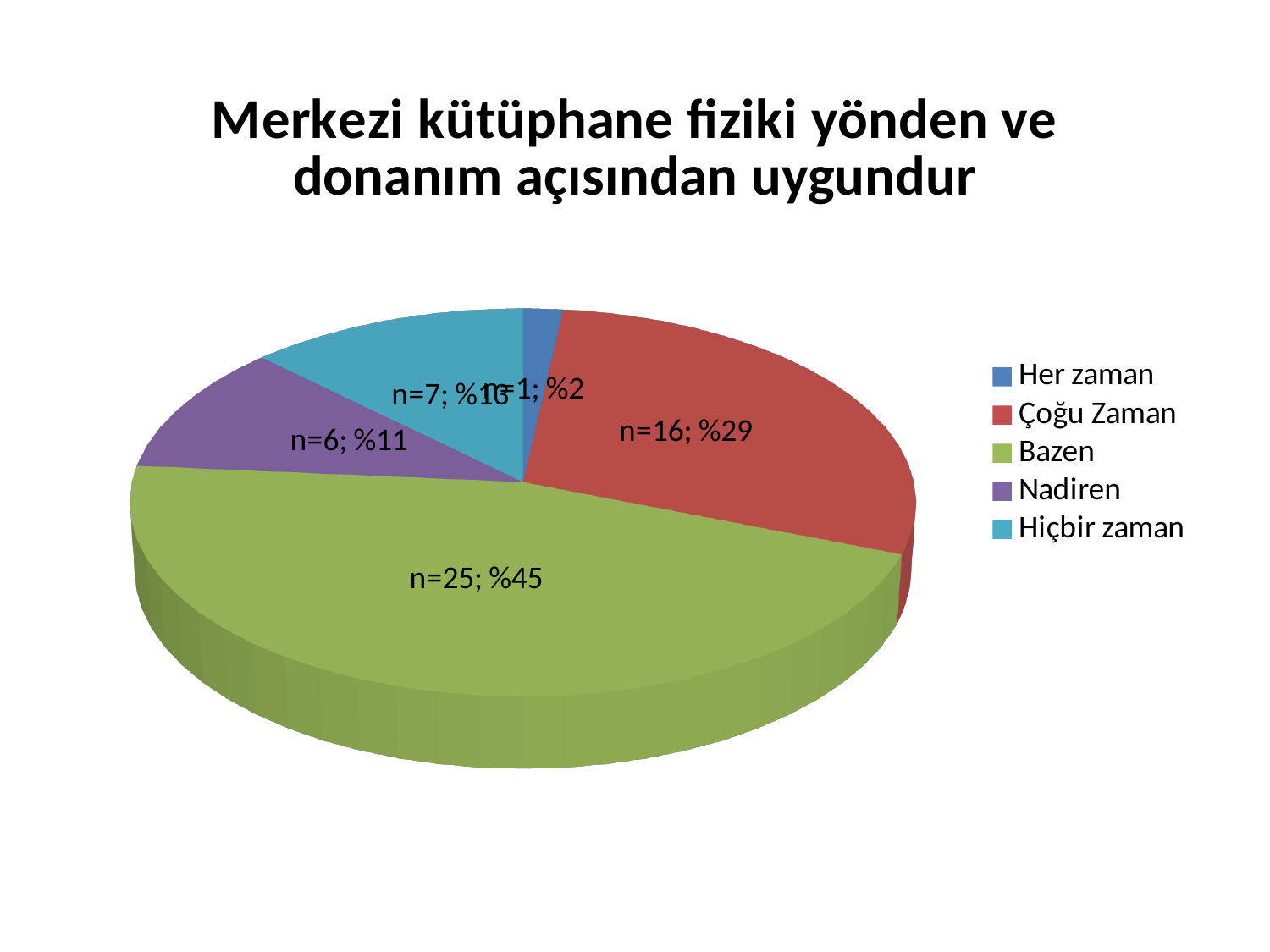
What kind of chart is shown on the slide? Pie chart What is the percentage shown for the Bazen slice? %45 Which category has the largest slice of the pie? Bazen Which slice is larger, Çoğu Zaman or Nadiren? Çoğu Zaman What is the count (n) shown for the Hiçbir zaman slice? n=7 What is the percentage shown for the Her zaman slice? %2 What is the count (n) shown for the Çoğu Zaman slice? n=16 How many slices does the pie chart have? 5 What is the percentage shown for the Nadiren slice? %11 Which category has the smallest slice of the pie? Her zaman What is the title of the chart? Merkezi kütüphane fiziki yönden ve donanım açısından uygundur What is the difference in percentage points between the Bazen slice and the Çoğu Zaman slice? 16